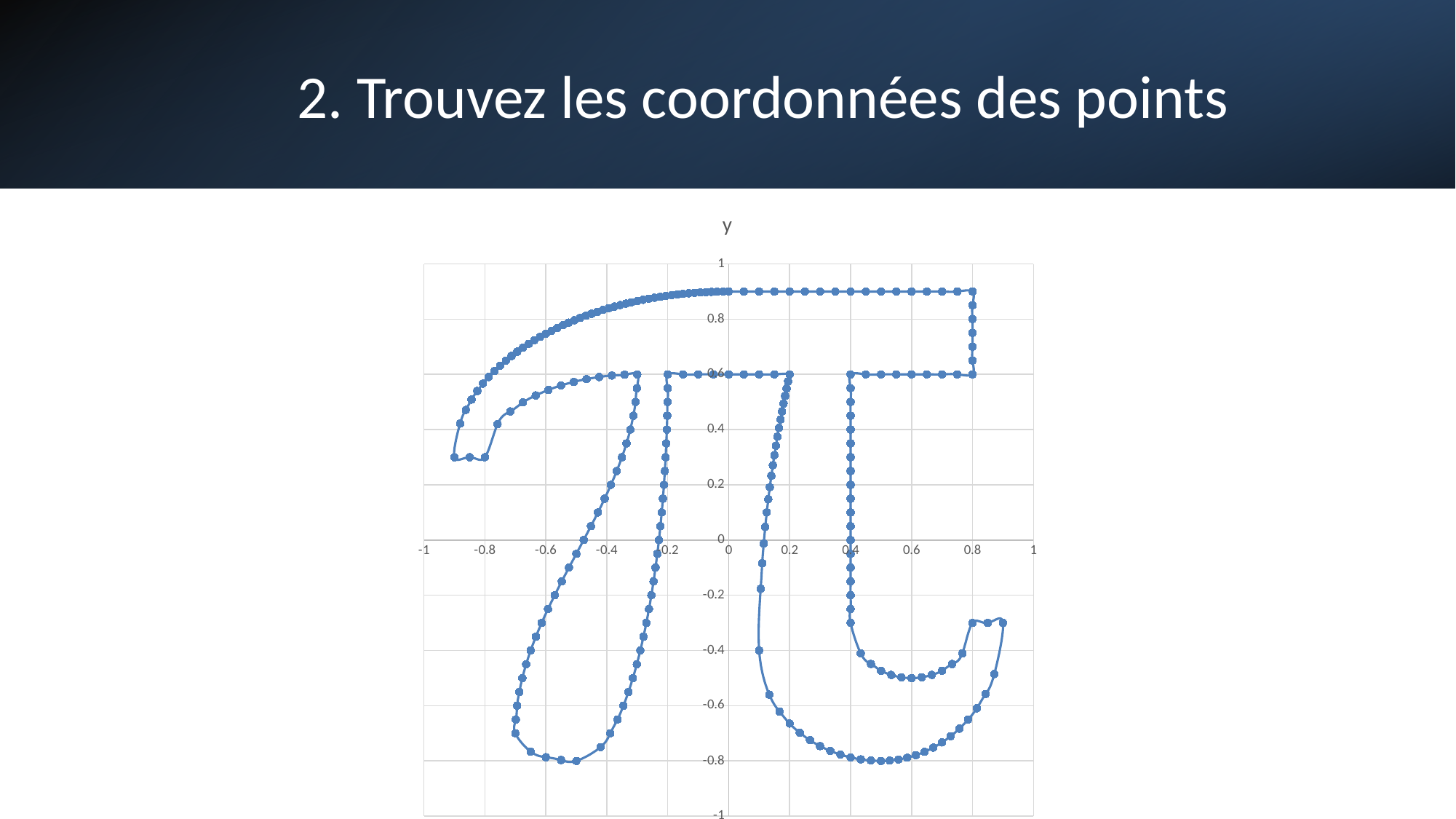
What shape do the plotted points trace out? The Greek letter pi (π) What is the minimum value shown on the y axis? -1 Is the highest y value reached by the plotted points greater or less than 0.8? greater Is the lowest y value reached by the plotted points greater or less than -0.6? less Is the smallest x value reached by the plotted points greater or less than -0.8? less What is the maximum value shown on the x axis? 1 What kind of chart is shown on the slide? Scatter chart with lines and markers What is the title of the chart? y What is the spacing between consecutive tick labels on the x axis? 0.2